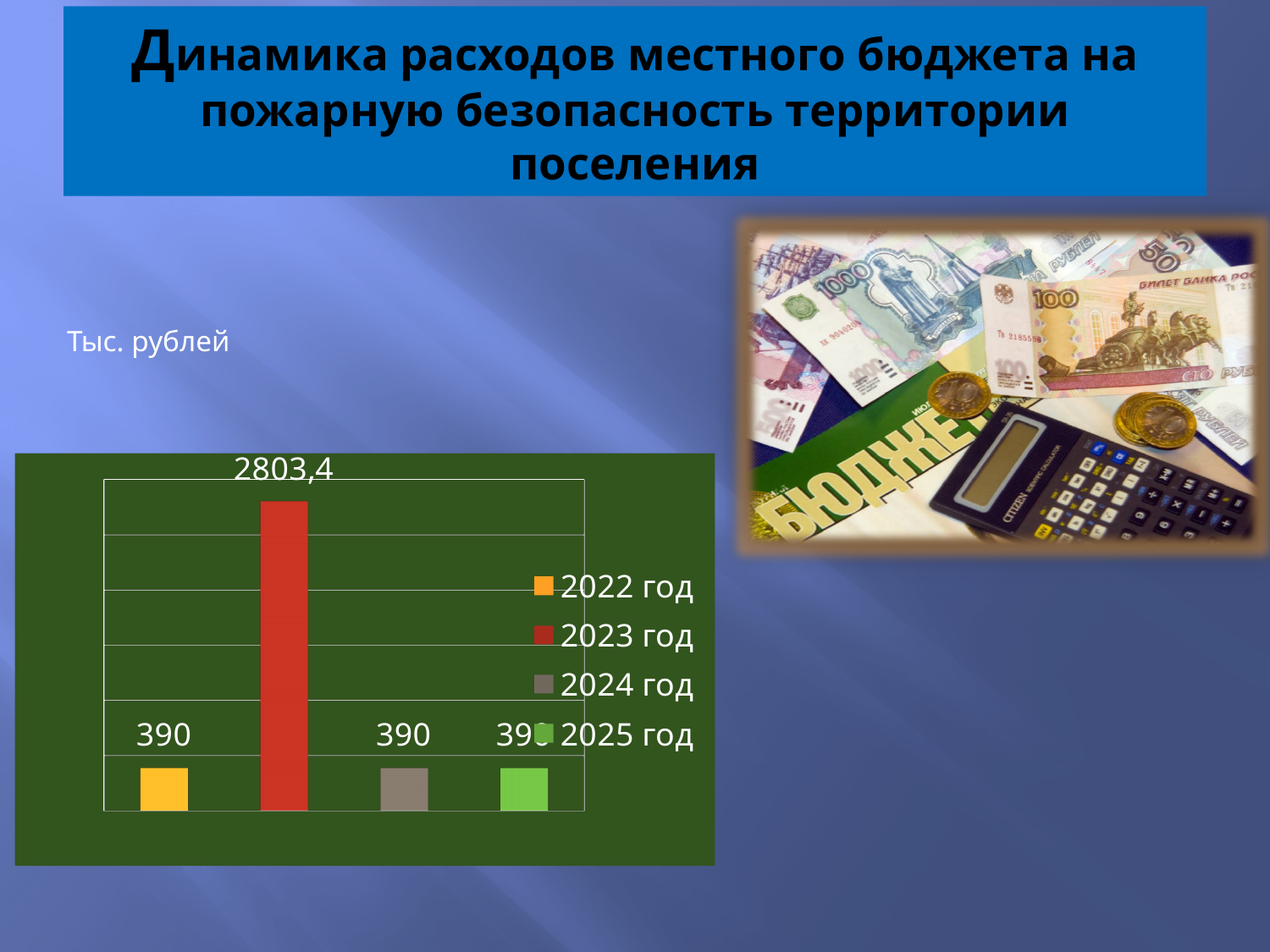
What is the value for 2023 год? 2803,4 Which is larger, the value for 2023 год or the value for 2024 год? 2023 год What is the difference between the values for 2023 год and 2022 год? 2413,4 How many bars are plotted in the chart? 4 What kind of chart is shown on the slide? bar chart What is the value for 2022 год? 390 How many series does the legend list? 4 What unit label is shown above the chart? Тыс. рублей What colour is the bar for 2023 год? red What is the value for 2024 год? 390 Which year has the highest value? 2023 год